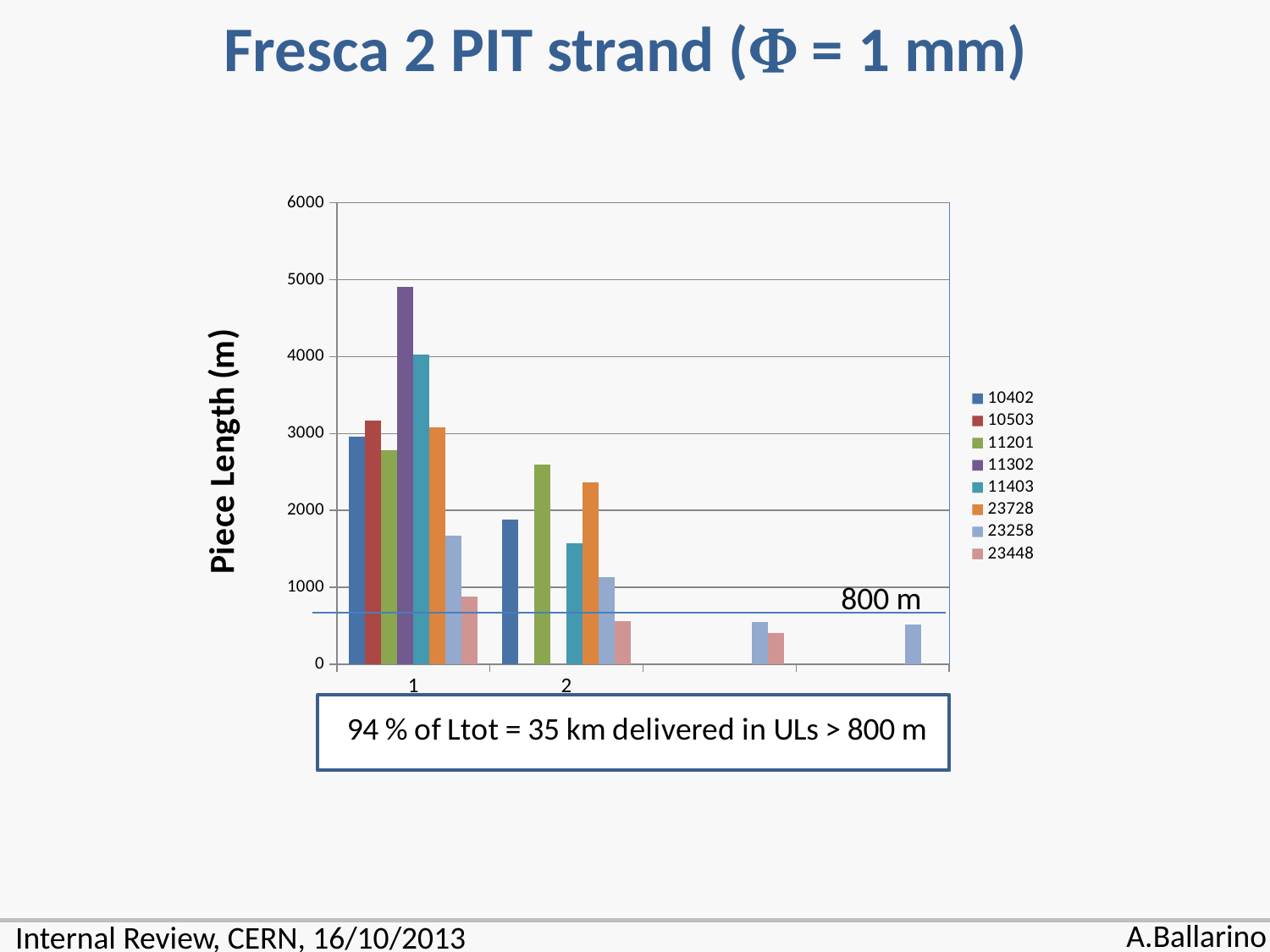
How many series does the legend list? 8 Which series has the lowest bar in category 1? 23448 How many bars are plotted in category 1? 8 What kind of chart is shown on the slide? bar chart Which series has the highest bar in category 2? 11201 In category 1, which is larger: the bar for series 11302 or the bar for series 11403? 11302 Is the value for series 23448 in category 1 greater or less than 1000? less Is the value for series 23448 in category 2 greater or less than 1000? less What is the title of the vertical axis? Piece Length (m) Which series has the highest bar in category 1? 11302 Is the value for series 11302 in category 1 greater or less than 4000? greater